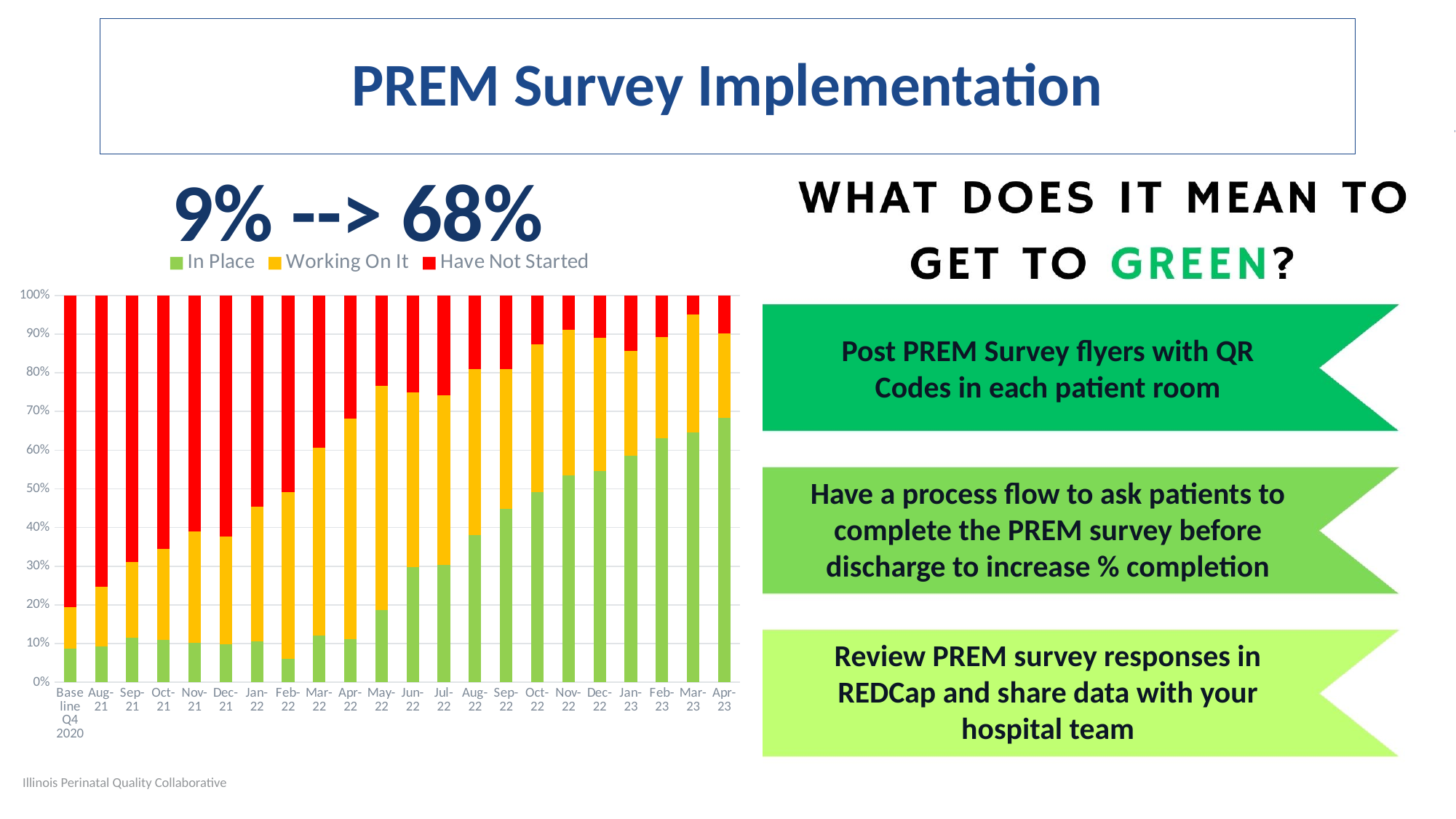
In which period is the 'In Place' share the highest? Apr-23 Is the 'In Place' value for Apr-23 greater or less than 60%? greater Does the 'In Place' share rise or fall from Baseline Q4 2020 to Apr-23? Rise What change in the 'In Place' percentage does the headline above the chart state? 9% --> 68% What is the total of the stacked bar for Apr-23? 100% In which period is the 'Have Not Started' share the lowest? Mar-23 How many series does the chart legend list? 3 Which is larger, the 'Have Not Started' share in Jan-22 or in Jan-23? Jan-22 How many time periods (bars) are plotted on the x axis of the chart? 22 What kind of chart is shown on the slide? Stacked bar chart Is the 'Have Not Started' value for Baseline Q4 2020 greater or less than 50%? greater What are the three series named in the chart legend? In Place, Working On It, Have Not Started